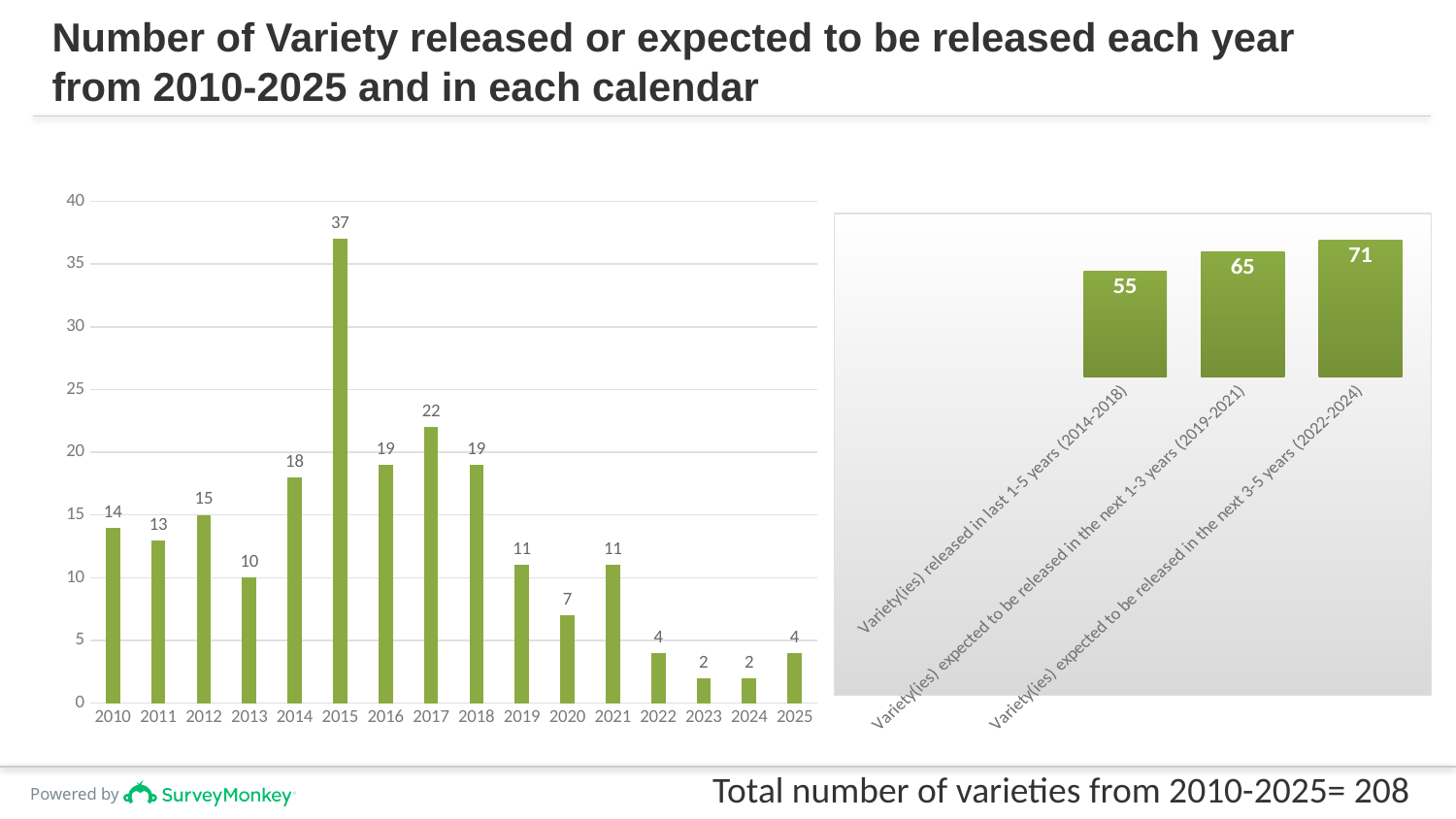
In the right chart, what is the difference between the value for the next 1-3 years (2019-2021) and the value for the last 1-5 years (2014-2018)? 10 In the left chart of varieties released each year, which year has the highest value? 2015 In the left chart of varieties released each year, what is the lowest value shown? 2 In the left chart of varieties released each year, what is the value for 2015? 37 In the left chart of varieties released each year, what is the difference between the values for 2015 and 2017? 15 In the right chart, how many categories are shown? 3 In the left chart of varieties released each year, do the values generally rise or fall from 2018 to 2024? Fall In the left chart of varieties released each year, how many years are shown on the x axis? 16 In the left chart of varieties released each year, what is the value for 2017? 22 What kind of chart is the left chart showing varieties released each year? Bar chart In the right chart, what is the value for varieties expected to be released in the next 3-5 years (2022-2024)? 71 In the left chart of varieties released each year, which is larger, the value for 2014 or the value for 2019? 2014